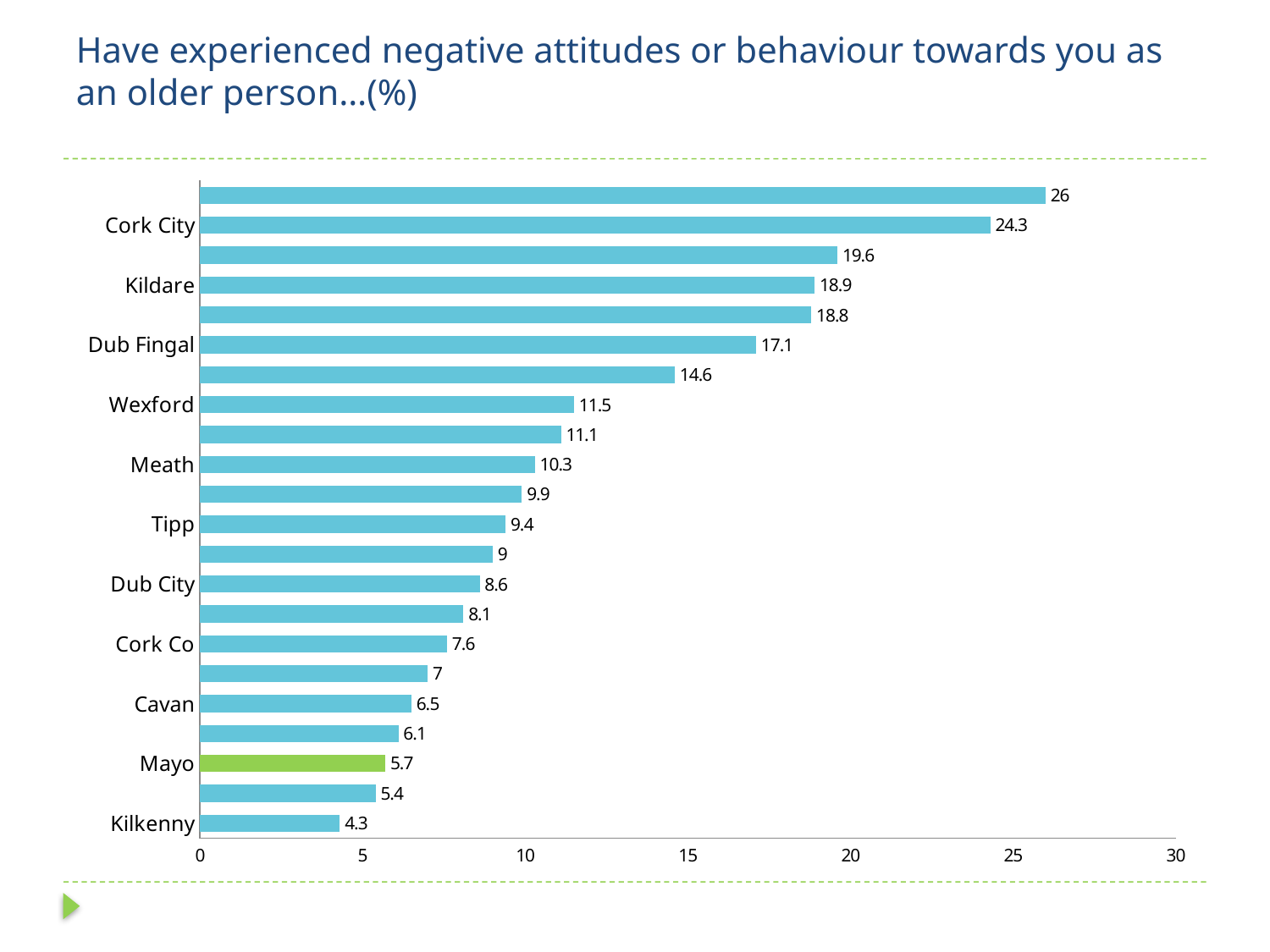
How many bars are plotted on the chart? 22 What kind of chart is shown on the slide? Bar chart Which is larger, the value for Wexford or the value for Meath? Wexford Which labelled county has the lowest value? Kilkenny What is the value for Dub Fingal? 17.1 What is the highest value shown on the chart? 26 What is the difference between the values for Dub Fingal and Dub City? 8.5 What is the difference between the values for Cork City and Kildare? 5.4 Which county's bar is coloured green instead of blue? Mayo What is the value for Cork City? 24.3 What is the value for Kildare? 18.9 What is the value for Mayo? 5.7